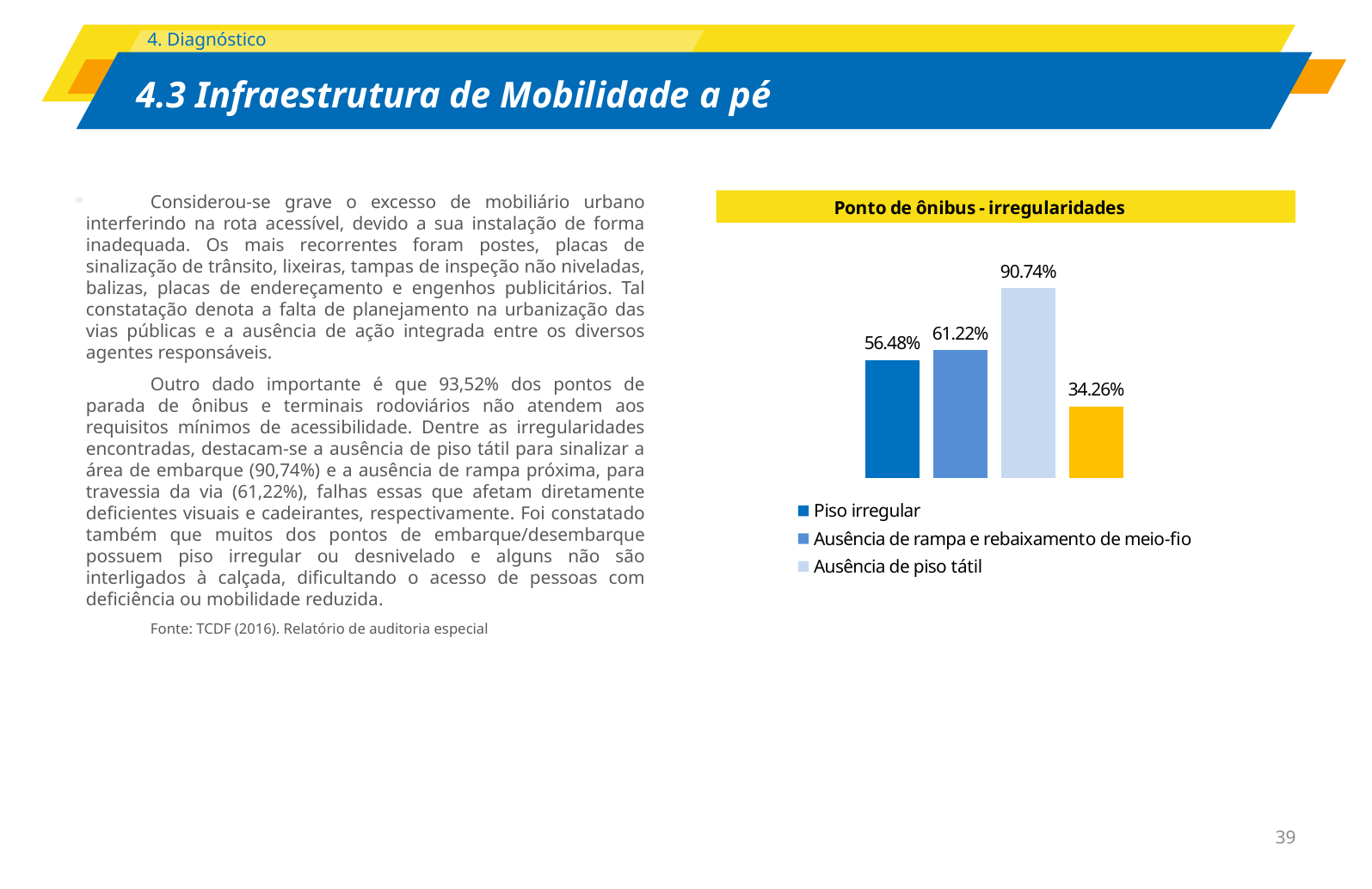
What is the value for Ausência de piso tátil? 90.74% What is the value for Ausência de rampa e rebaixamento de meio-fio? 61.22% Which legend category has the highest value in the chart? Ausência de piso tátil Which is larger: Piso irregular or Ausência de rampa e rebaixamento de meio-fio? Ausência de rampa e rebaixamento de meio-fio What value is labelled on the yellow (fourth) bar of the chart? 34.26% How much higher is Ausência de piso tátil than Piso irregular? 34.26 percentage points What is the difference between Ausência de rampa e rebaixamento de meio-fio and Piso irregular? 4.74 percentage points What is the value for Piso irregular in the chart? 56.48% What type of chart is shown on the slide? Bar chart How many entries does the chart legend list? 3 What is the lowest value labelled on the chart? 34.26% How many bars are plotted in the chart? 4